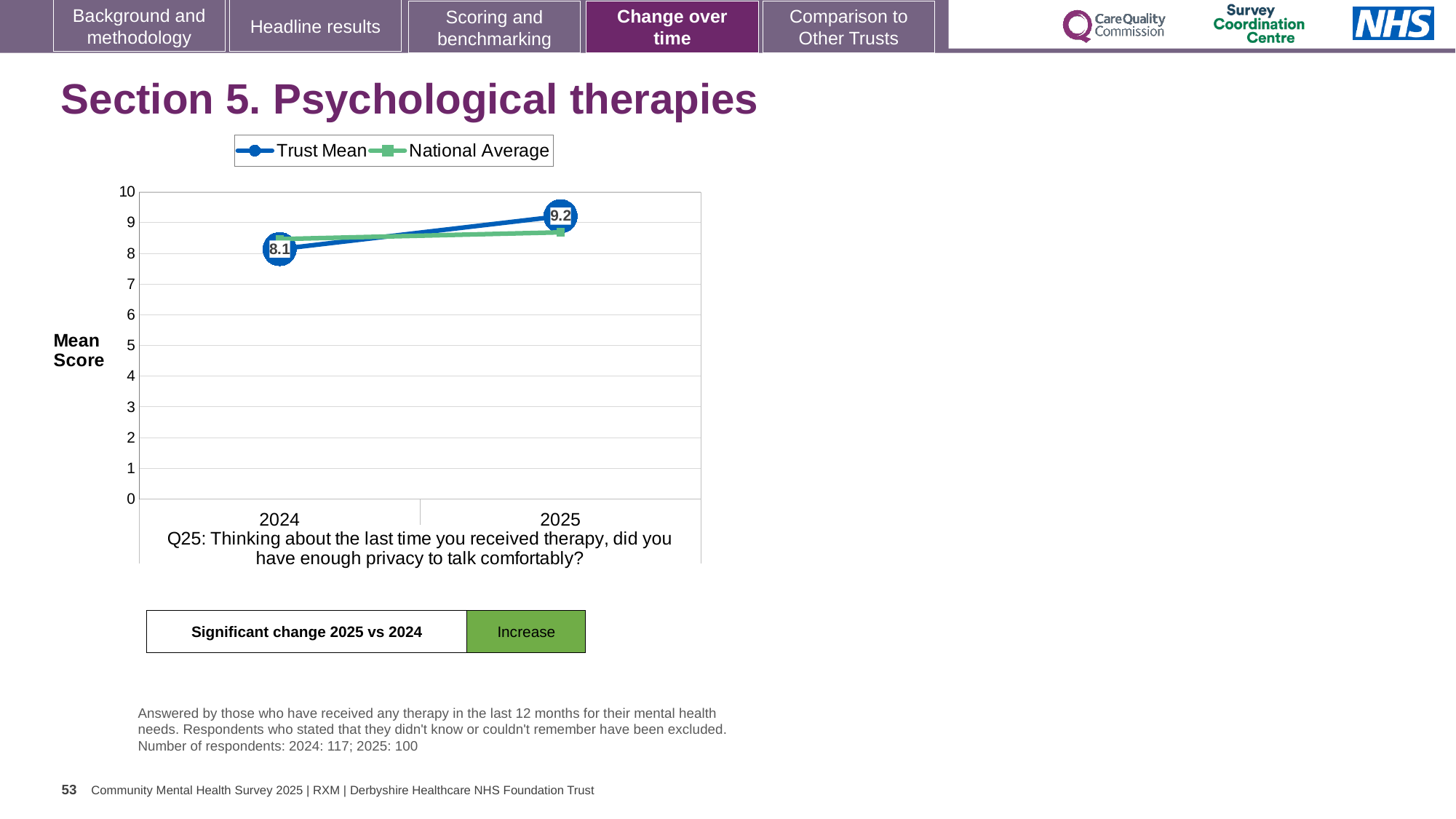
How many years are plotted on the x axis? 2 What kind of chart is shown on the slide? line chart What is the Trust Mean score for 2025? 9.2 How many series does the legend list? 2 In 2025, which is larger: the Trust Mean or the National Average? Trust Mean In which year is the Trust Mean score lowest? 2024 What is the Trust Mean score for 2024? 8.1 In which year is the Trust Mean score highest? 2025 Is the National Average value for 2025 greater or less than 9? less Does the Trust Mean score rise or fall from 2024 to 2025? rise Is the National Average value for 2024 greater or less than 8? greater By how much did the Trust Mean score change from 2024 to 2025? 1.1